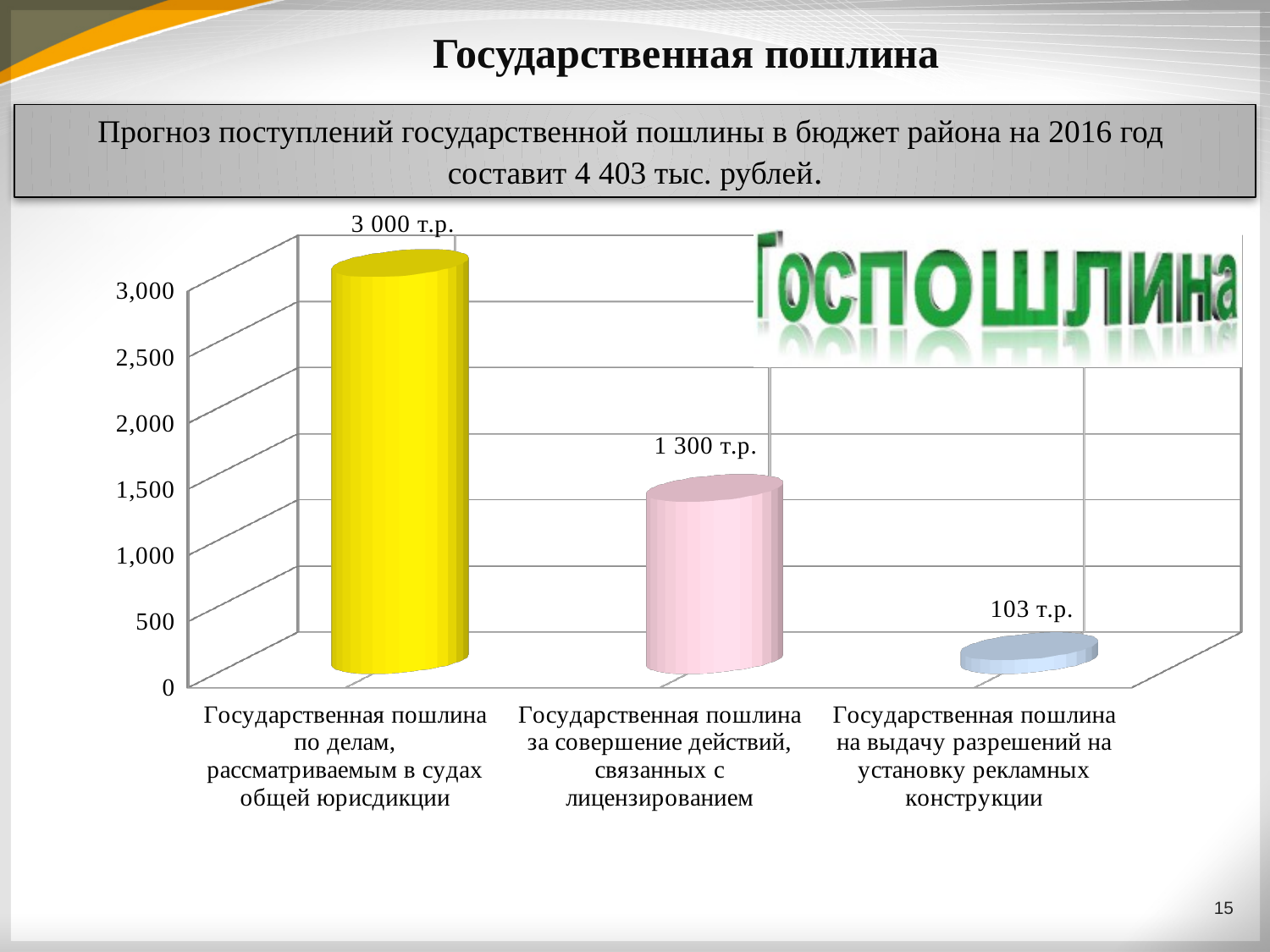
What is the value for «Государственная пошлина за совершение действий, связанных с лицензированием»? 1 300 т.р. What is the difference between the value for «Государственная пошлина за совершение действий, связанных с лицензированием» and the value for «Государственная пошлина на выдачу разрешений на установку рекламных конструкции»? 1 197 т.р. Which category has the lowest value? Государственная пошлина на выдачу разрешений на установку рекламных конструкции How many categories are shown in the chart? 3 Is the value for «Государственная пошлина за совершение действий, связанных с лицензированием» greater or less than 1,000? greater Which is larger: the value for «Государственная пошлина за совершение действий, связанных с лицензированием» or the value for «Государственная пошлина на выдачу разрешений на установку рекламных конструкции»? Государственная пошлина за совершение действий, связанных с лицензированием What is the value for «Государственная пошлина по делам, рассматриваемым в судах общей юрисдикции»? 3 000 т.р. What is the value for «Государственная пошлина на выдачу разрешений на установку рекламных конструкции»? 103 т.р. What kind of chart is shown on the slide? bar chart Do the values rise or fall from left to right across the categories? fall Which category has the highest value? Государственная пошлина по делам, рассматриваемым в судах общей юрисдикции What is the difference between the value for «Государственная пошлина по делам, рассматриваемым в судах общей юрисдикции» and the value for «Государственная пошлина за совершение действий, связанных с лицензированием»? 1 700 т.р.